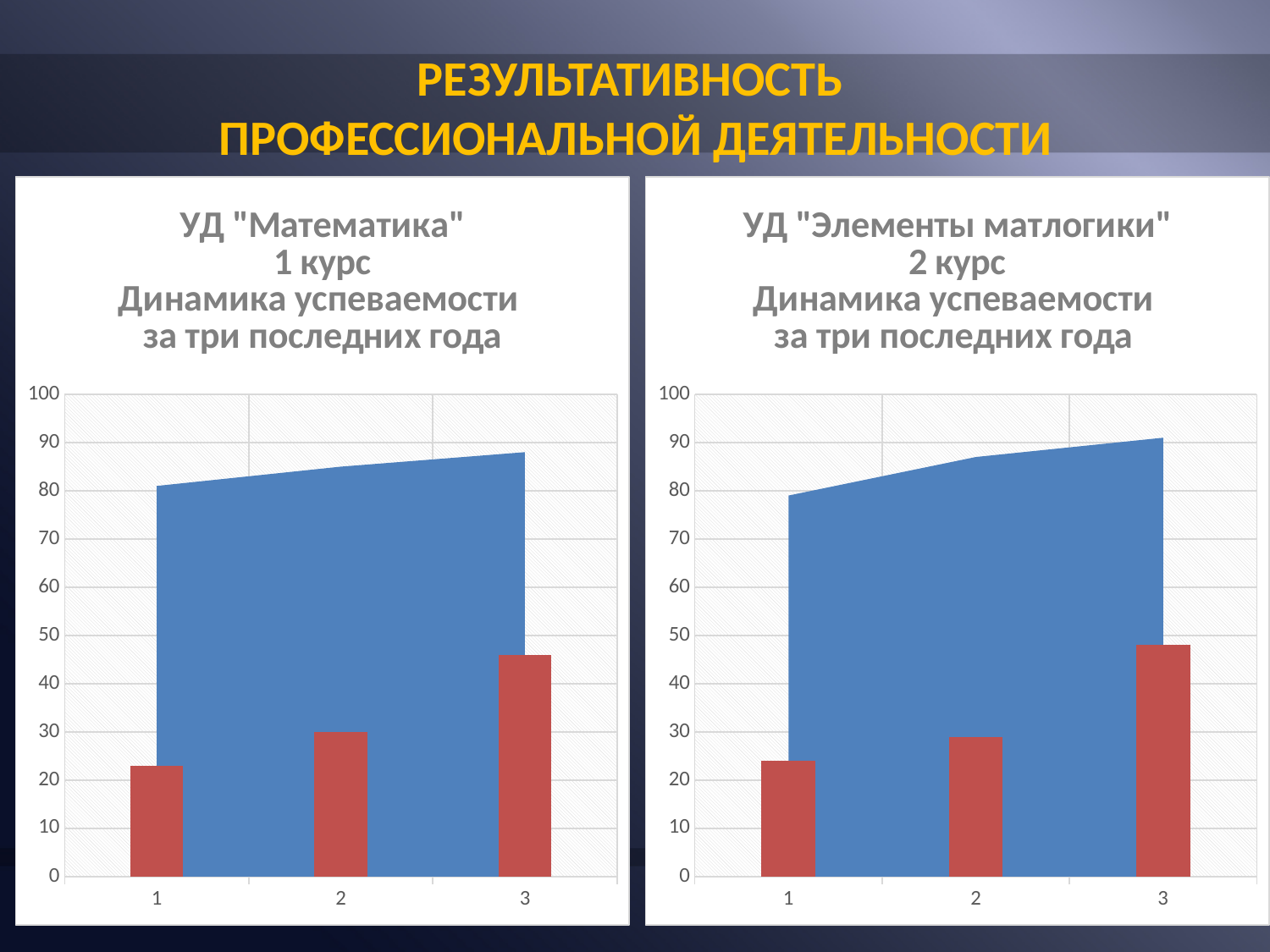
What is the title of the chart on the right side of the slide? УД "Элементы матлогики" 2 курс Динамика успеваемости за три последних года In the right chart (УД "Элементы матлогики" 2 курс), is the blue area value for category 1 greater or less than 70? greater In the left chart (УД "Математика" 1 курс), which category has the highest red bar? 3 In the left chart (УД "Математика" 1 курс), how many categories are shown on the x axis? 3 In the right chart (УД "Элементы матлогики" 2 курс), which is larger: the red bar for category 2 or the red bar for category 3? category 3 In the left chart (УД "Математика" 1 курс), is the red bar for category 1 greater or less than 30? less In the right chart (УД "Элементы матлогики" 2 курс), is the red bar for category 3 greater or less than 40? greater In the right chart (УД "Элементы матлогики" 2 курс), how many categories are shown on the x axis? 3 In the right chart (УД "Элементы матлогики" 2 курс), does the blue area rise or fall from category 1 to category 3? rise In the right chart (УД "Элементы матлогики" 2 курс), which category has the lowest red bar? 1 In the left chart (УД "Математика" 1 курс), do the red bars rise or fall from category 1 to category 3? rise